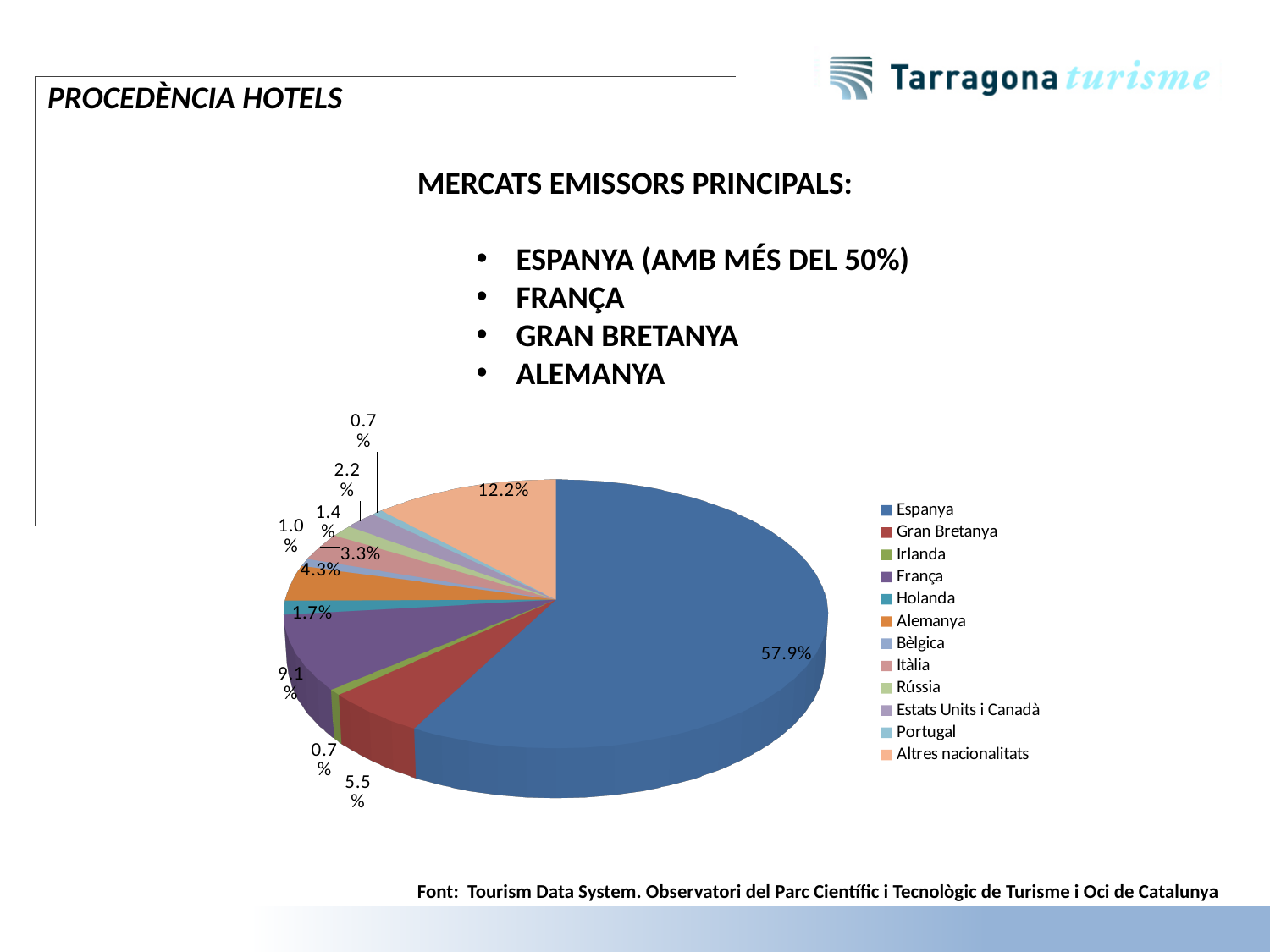
How many categories does the legend of the pie chart list? 12 What percentage is shown for Altres nacionalitats in the pie chart? 12.2% What percentage is shown for França in the pie chart? 9.1% What percentage is shown for Gran Bretanya in the pie chart? 5.5% Which category has the largest slice of the pie chart? Espanya What percentage of the pie chart does Espanya account for? 57.9% What percentage is shown for Alemanya in the pie chart? 4.3% What colour is the Espanya slice in the pie chart? Blue What percentage is shown for Holanda in the pie chart? 1.7% Which has a larger share of the pie chart, França or Gran Bretanya? França What kind of chart is shown on the slide? Pie chart What is the difference in percentage points between the Espanya slice and the Altres nacionalitats slice? 45.7 percentage points